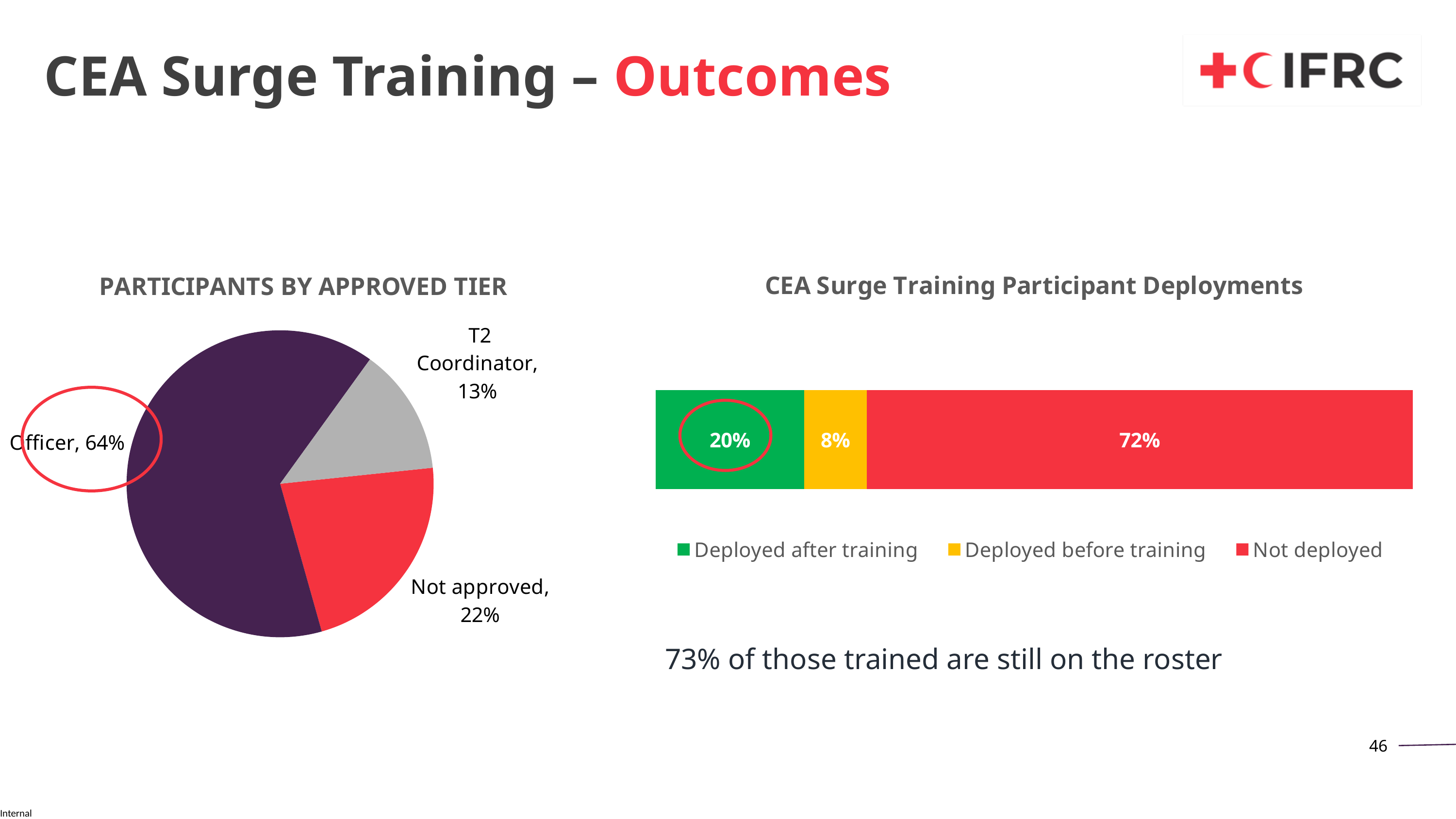
In the 'PARTICIPANTS BY APPROVED TIER' pie chart, what share is labelled for T2 Coordinator? 13% In the 'CEA Surge Training Participant Deployments' chart, what percentage is shown for Deployed after training? 20% In the 'CEA Surge Training Participant Deployments' chart, what percentage is shown for Not deployed? 72% In the 'PARTICIPANTS BY APPROVED TIER' pie chart, how many slices are there? 3 In the 'PARTICIPANTS BY APPROVED TIER' pie chart, what share is labelled for Not approved? 22% In the 'PARTICIPANTS BY APPROVED TIER' pie chart, which category has the smallest slice? T2 Coordinator In the 'PARTICIPANTS BY APPROVED TIER' pie chart, what share is labelled for Officer? 64% In the 'CEA Surge Training Participant Deployments' chart, how many series does the legend list? 3 What kind of chart is 'CEA Surge Training Participant Deployments'? Stacked bar chart In the 'PARTICIPANTS BY APPROVED TIER' pie chart, which category has the largest slice? Officer In the 'CEA Surge Training Participant Deployments' chart, what is the difference between Not deployed and Deployed before training? 64% What kind of chart is 'PARTICIPANTS BY APPROVED TIER'? Pie chart